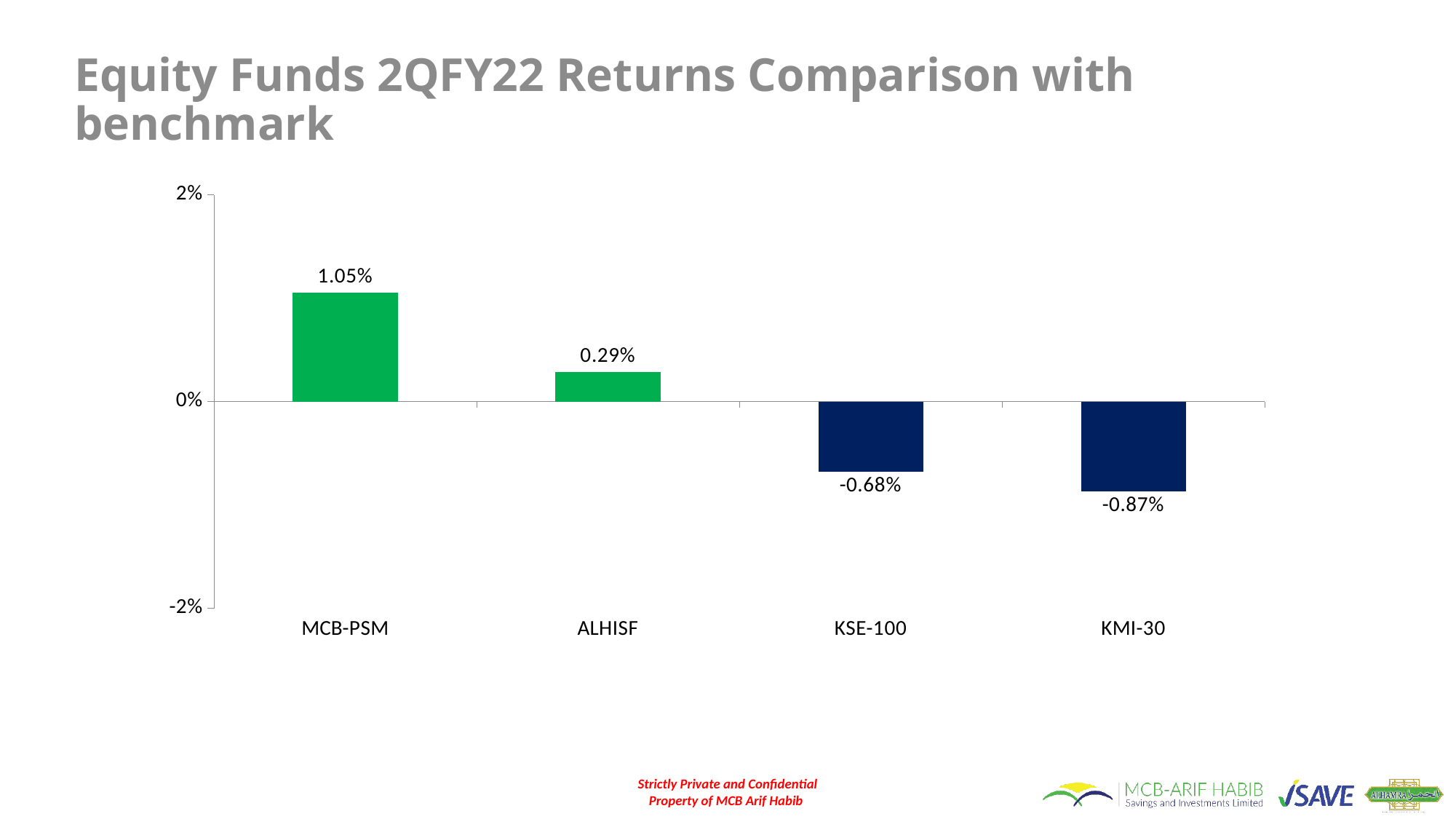
Which category has the highest return? MCB-PSM How many categories are shown on the chart? 4 Which has a higher return, KSE-100 or KMI-30? KSE-100 What kind of chart is shown on the slide? Bar chart What is the difference between the returns of MCB-PSM and ALHISF? 0.76% What is the title of the slide? Equity Funds 2QFY22 Returns Comparison with benchmark Is the value for MCB-PSM greater or less than 0%? greater What is the return shown for KMI-30? -0.87% What is the return shown for MCB-PSM? 1.05% What is the return shown for ALHISF? 0.29% What is the return shown for KSE-100? -0.68% Which category has the lowest return? KMI-30